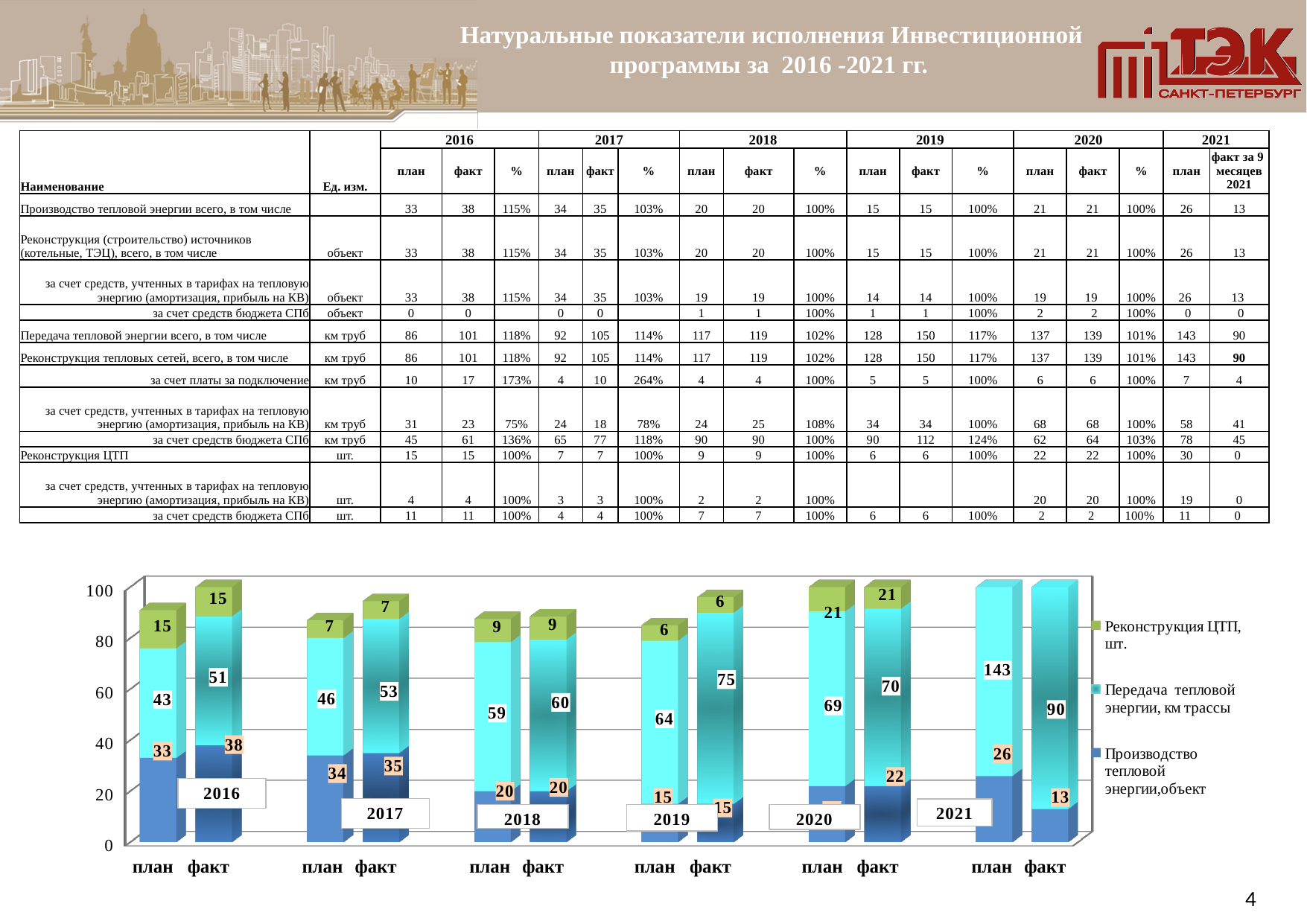
In the bar chart, what is the value of 'Производство тепловой энергии, объект' for the 2016 факт bar? 38 How many bars are plotted in the bar chart? 12 In the bar chart, what is the value of 'Реконструкция ЦТП, шт.' for the 2020 факт bar? 21 In the bar chart, which is larger for 'Производство тепловой энергии, объект' in 2017: план or факт? факт In the bar chart, what is the difference between the 'Передача тепловой энергии' values for 2019 факт and 2019 план? 11 In the bar chart, which bar has the lowest labelled value for 'Производство тепловой энергии, объект'? 2021 факт In the bar chart, what is the value of 'Реконструкция ЦТП, шт.' for the 2018 план bar? 9 In the bar chart, which bar has the highest labelled value for 'Передача тепловой энергии, км трассы'? 2021 план What kind of chart is shown at the bottom of the slide? stacked bar chart How many series does the legend of the bar chart list? 3 In the bar chart, what is the value of 'Передача тепловой энергии, км трассы' for the 2021 план bar? 143 In the bar chart, what is the total of the three labelled segments of the 2016 план bar? 91